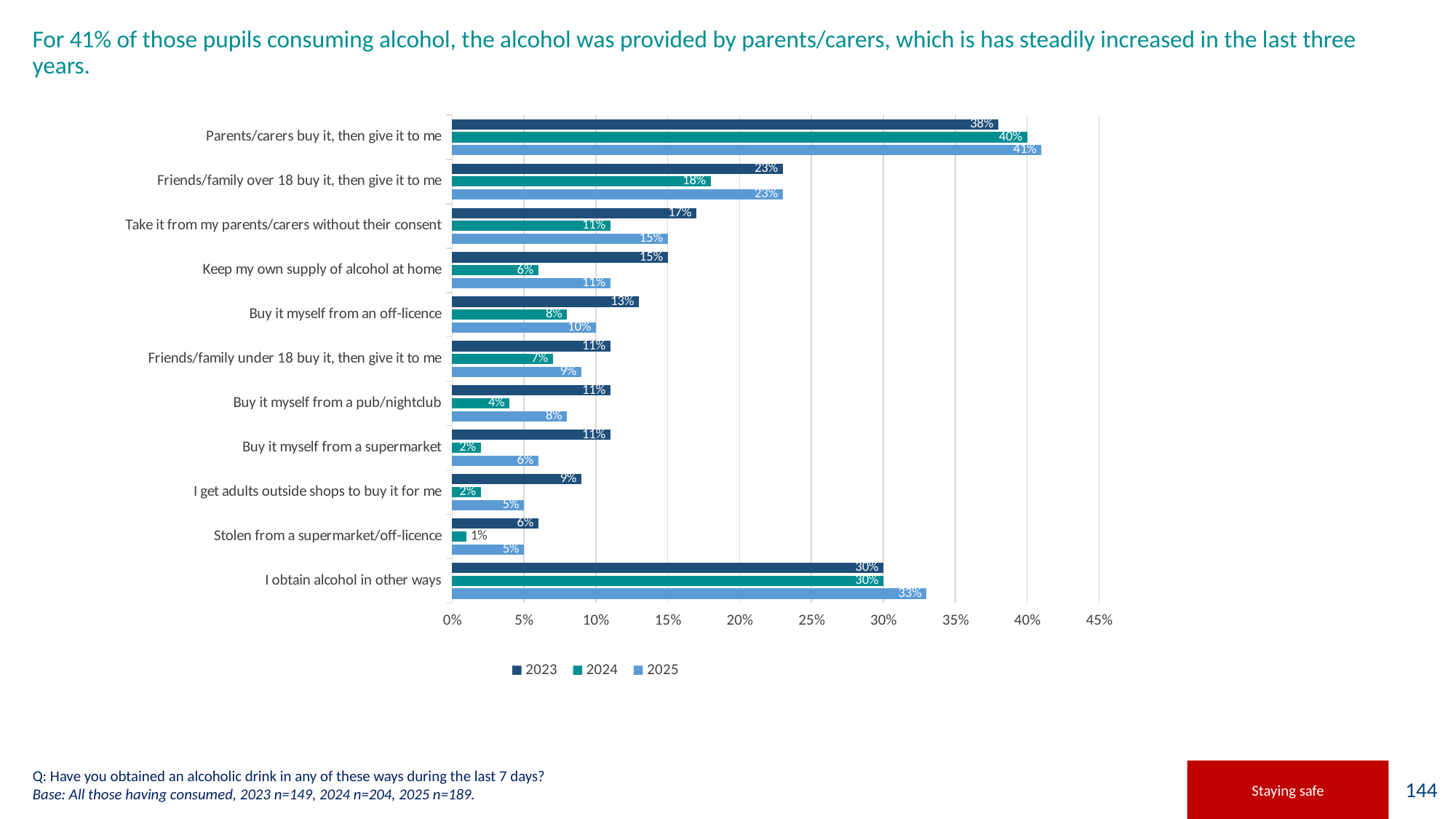
What is the 2024 value for 'Friends/family over 18 buy it, then give it to me'? 18% Which is larger for 'Keep my own supply of alcohol at home': the 2023 value or the 2024 value? 2023 What is the 2024 value for 'Stolen from a supermarket/off-licence'? 1% Which category has the lowest 2024 value? Stolen from a supermarket/off-licence What is the difference between the 2025 and 2023 values for 'Parents/carers buy it, then give it to me'? 3% How many series does the legend list? 3 What is the 2023 value for 'Take it from my parents/carers without their consent'? 17% What kind of chart is shown on the slide? Bar chart Is the 2025 value for 'I obtain alcohol in other ways' greater or less than 30%? greater What is the 2025 value for 'Parents/carers buy it, then give it to me'? 41% Which category has the highest 2025 value? Parents/carers buy it, then give it to me How many categories are shown on the chart? 11